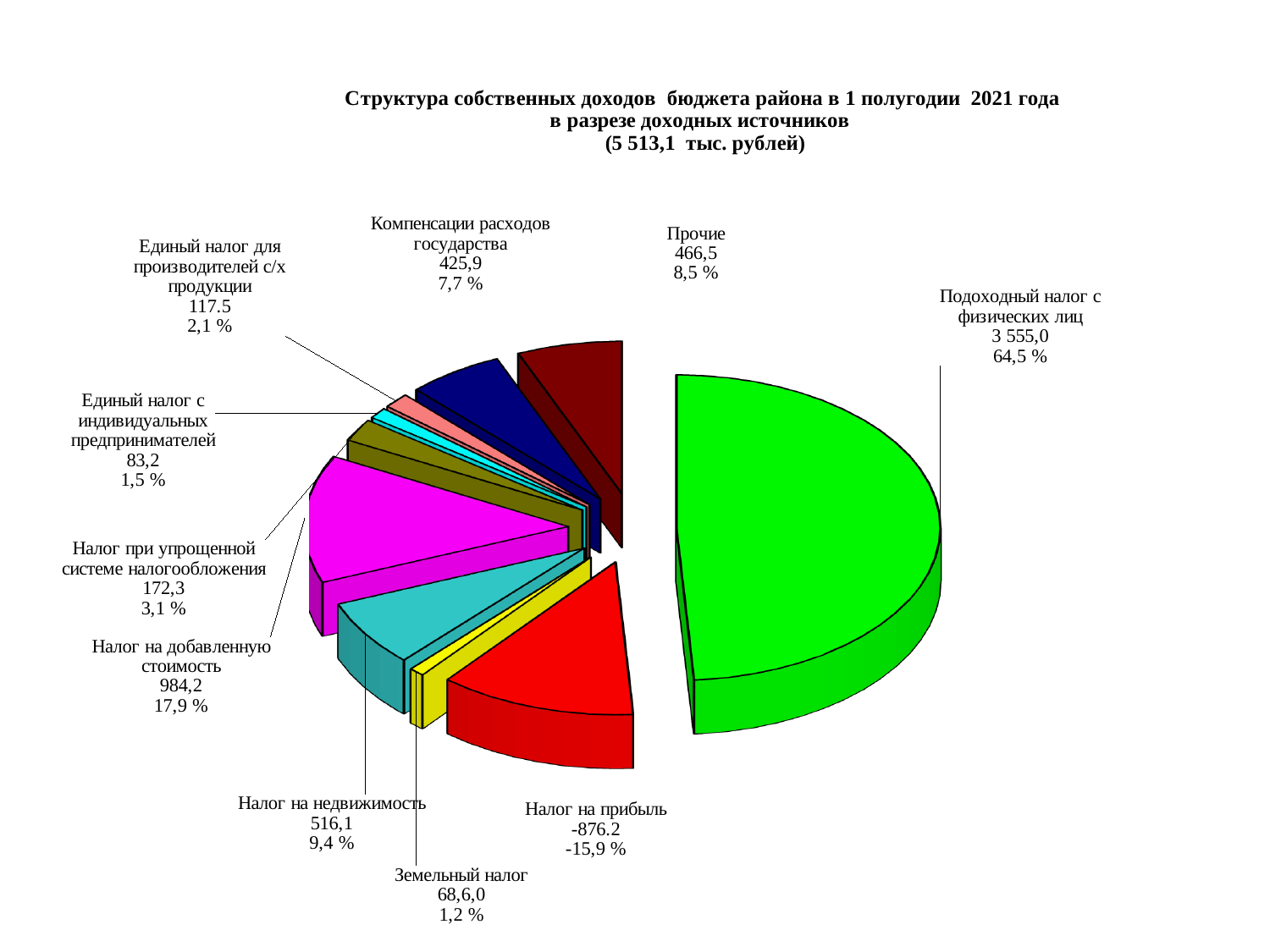
What type of chart is shown on the slide? pie chart What share of the pie does Прочие represent? 8,5 % What is the value for Подоходный налог с физических лиц? 3 555,0 Which category has the highest value? Подоходный налог с физических лиц What is the difference between the values for Налог на добавленную стоимость and Налог на недвижимость? 468,1 What is the value for Налог на недвижимость? 516,1 What total amount in thousand rubles is stated in the chart title? 5 513,1 тыс. рублей How many categories are shown in the pie chart? 10 What share of the pie does Единый налог с индивидуальных предпринимателей represent? 1,5 % Which is larger: the value for Прочие or the value for Компенсации расходов государства? Прочие What share of the pie does Налог на добавленную стоимость represent? 17,9 % Which category has the lowest value? Налог на прибыль